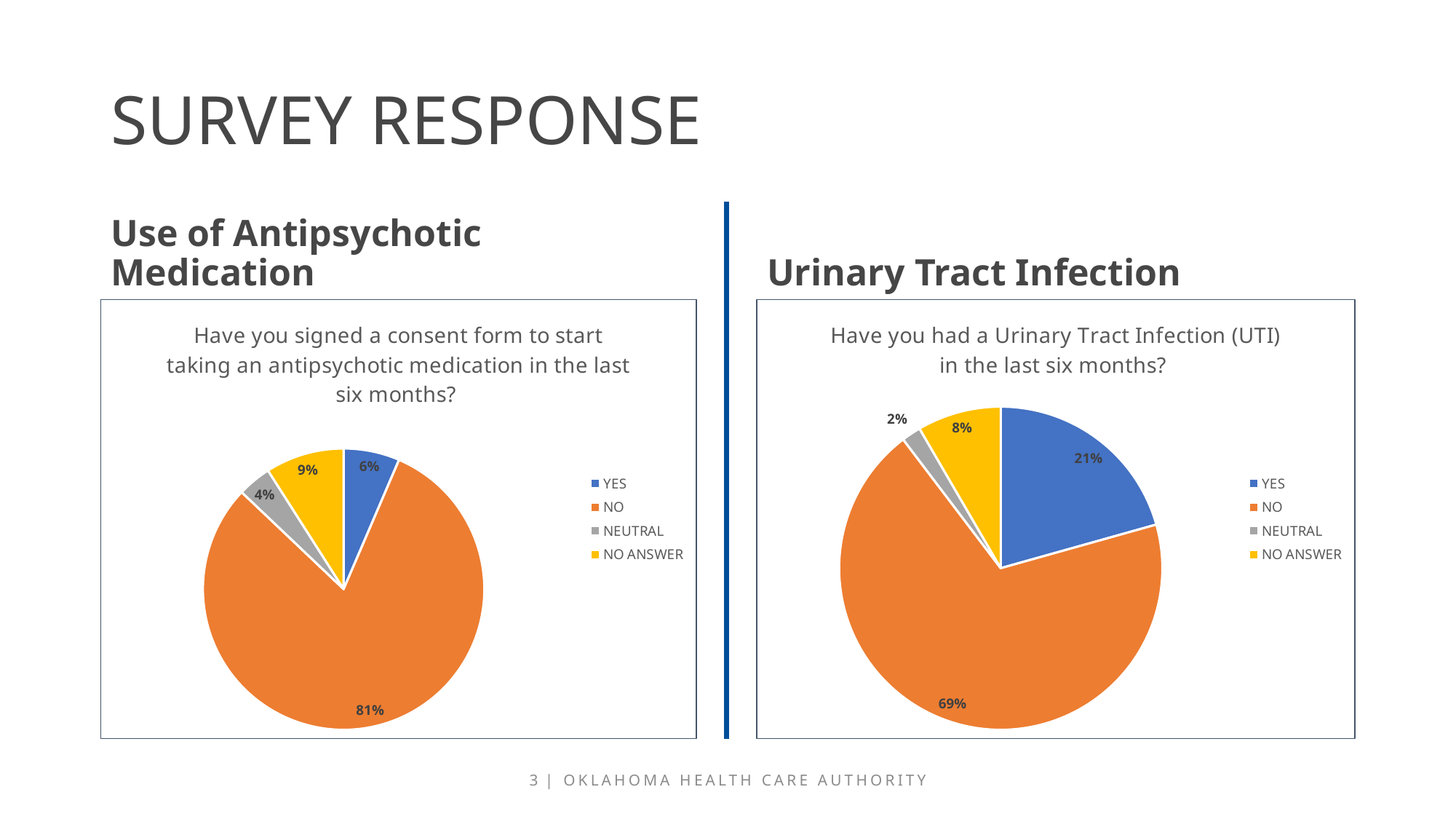
In the right pie chart (Urinary Tract Infection), which response has the smallest share? NEUTRAL In the left pie chart (Use of Antipsychotic Medication), what percentage of respondents answered NO? 81% In the right pie chart (Urinary Tract Infection), what percentage of respondents gave NO ANSWER? 8% In the right pie chart (Urinary Tract Infection), what is the difference between the NO share and the YES share? 48% How many response categories does the legend of the right pie chart (Urinary Tract Infection) list? 4 What type of chart is used on the left side of the slide (Use of Antipsychotic Medication)? Pie chart In the left pie chart (Use of Antipsychotic Medication), what is the combined share of YES and NEUTRAL responses? 10% In the right pie chart (Urinary Tract Infection), what percentage of respondents answered YES? 21% In the left pie chart (Use of Antipsychotic Medication), which is larger: the NO ANSWER share or the NEUTRAL share? NO ANSWER In the left pie chart (Use of Antipsychotic Medication), which response has the largest share? NO In the right pie chart (Urinary Tract Infection), what colour represents the NO response? Orange In the left pie chart (Use of Antipsychotic Medication), what percentage of respondents answered YES? 6%